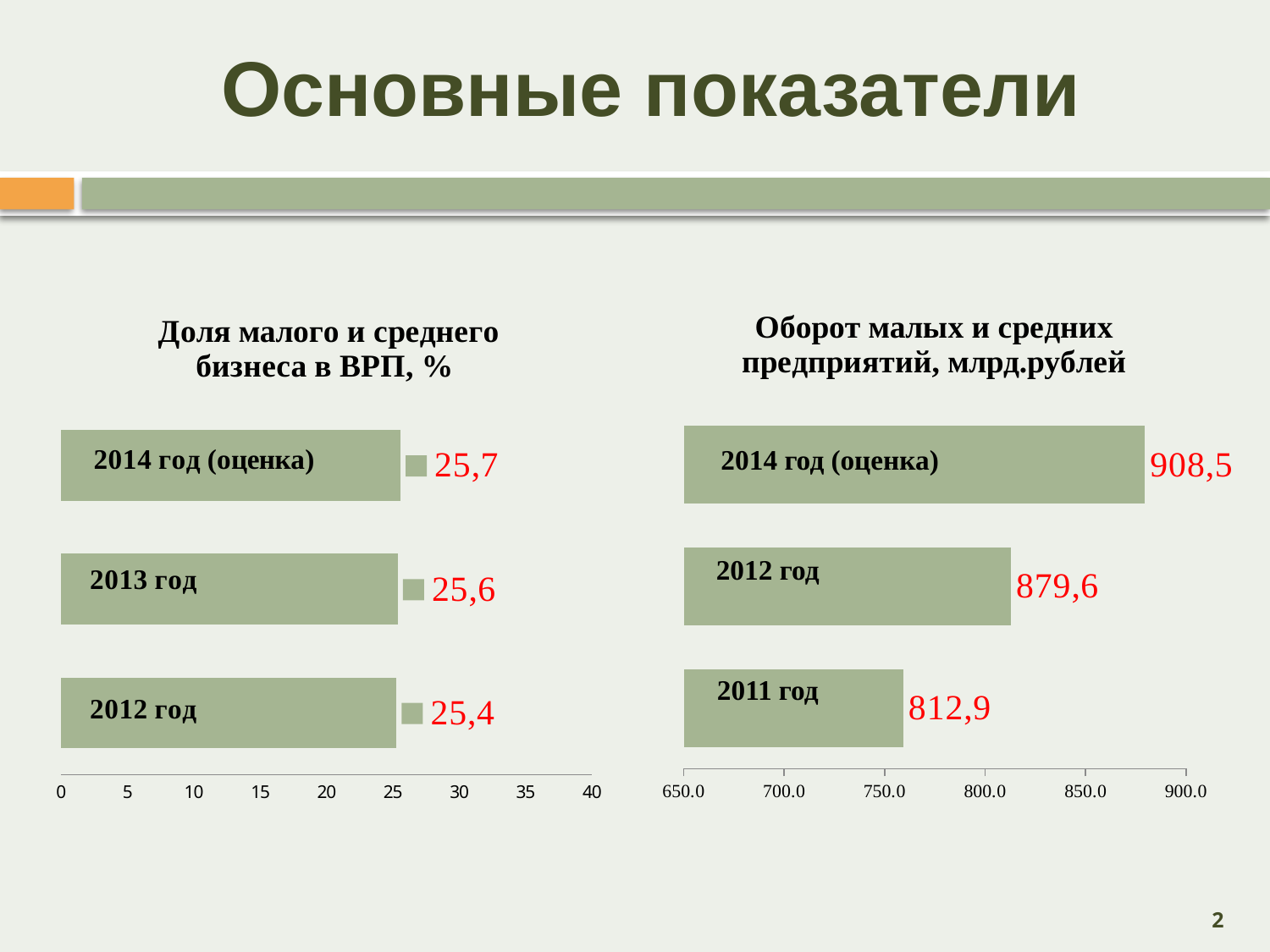
In the chart 'Оборот малых и средних предприятий, млрд.рублей', which is larger: the value for 2012 год or the value for 2011 год? 2012 год In the chart 'Доля малого и среднего бизнеса в ВРП, %', which category has the lowest value? 2012 год In the chart 'Доля малого и среднего бизнеса в ВРП, %', how many categories are shown? 3 In the chart 'Оборот малых и средних предприятий, млрд.рублей', which category has the highest value? 2014 год (оценка) In the chart 'Оборот малых и средних предприятий, млрд.рублей', what is the difference between the values for 2014 год (оценка) and 2011 год? 95,6 In the chart 'Оборот малых и средних предприятий, млрд.рублей', what is the value for 2011 год? 812,9 What is the title of the chart on the left side of the slide? Доля малого и среднего бизнеса в ВРП, % In the chart 'Доля малого и среднего бизнеса в ВРП, %', what is the value for 2014 год (оценка)? 25,7 What kind of chart is 'Оборот малых и средних предприятий, млрд.рублей'? Bar chart In the chart 'Оборот малых и средних предприятий, млрд.рублей', what is the value for 2012 год? 879,6 In the chart 'Доля малого и среднего бизнеса в ВРП, %', what is the difference between the values for 2014 год (оценка) and 2012 год? 0,3 In the chart 'Доля малого и среднего бизнеса в ВРП, %', what is the value for 2013 год? 25,6